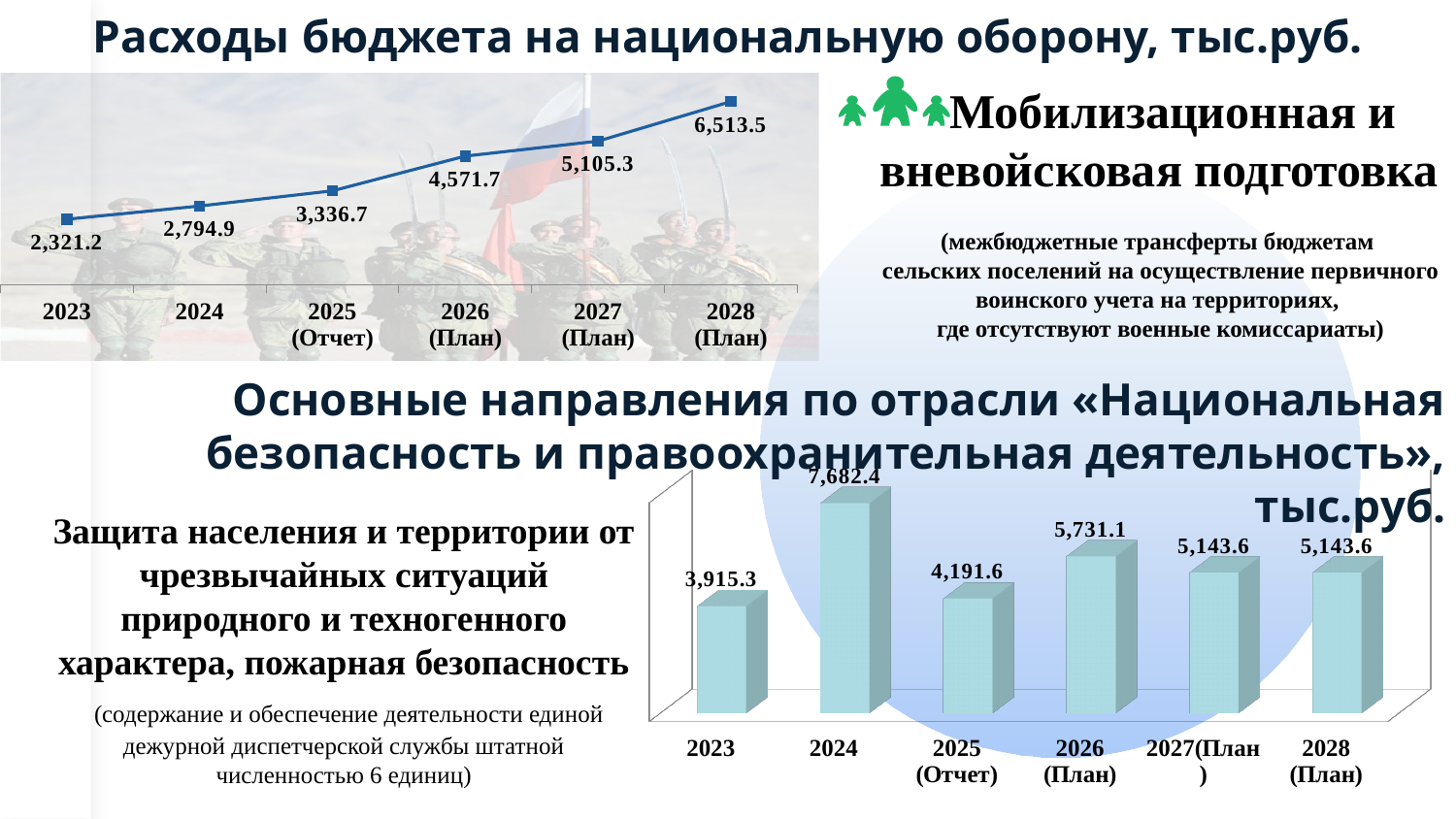
What kind of chart is the bottom chart (Защита населения и территории от чрезвычайных ситуаций)? bar chart On the bottom bar chart (Защита населения и территории от чрезвычайных ситуаций), what is the difference between the 2024 and 2023 values? 3,767.1 On the top line chart 'Расходы бюджета на национальную оборону, тыс.руб.', what is the value for 2028 (План)? 6,513.5 On the top line chart 'Расходы бюджета на национальную оборону, тыс.руб.', which year has the highest value? 2028 (План) What kind of chart is the top chart 'Расходы бюджета на национальную оборону, тыс.руб.'? line chart On the bottom bar chart (Защита населения и территории от чрезвычайных ситуаций), which is larger: the value for 2026 (План) or the value for 2025 (Отчет)? 2026 (План) How many years are plotted on the top line chart 'Расходы бюджета на национальную оборону, тыс.руб.'? 6 On the bottom bar chart (Защита населения и территории от чрезвычайных ситуаций), which year has the lowest value? 2023 On the top line chart 'Расходы бюджета на национальную оборону, тыс.руб.', what is the value for 2023? 2,321.2 On the top line chart 'Расходы бюджета на национальную оборону, тыс.руб.', what is the difference between the 2026 (План) and 2025 (Отчет) values? 1,235.0 On the top line chart 'Расходы бюджета на национальную оборону, тыс.руб.', do the values rise or fall from 2023 to 2028? rise On the bottom bar chart (Защита населения и территории от чрезвычайных ситуаций), what is the value for 2024? 7,682.4